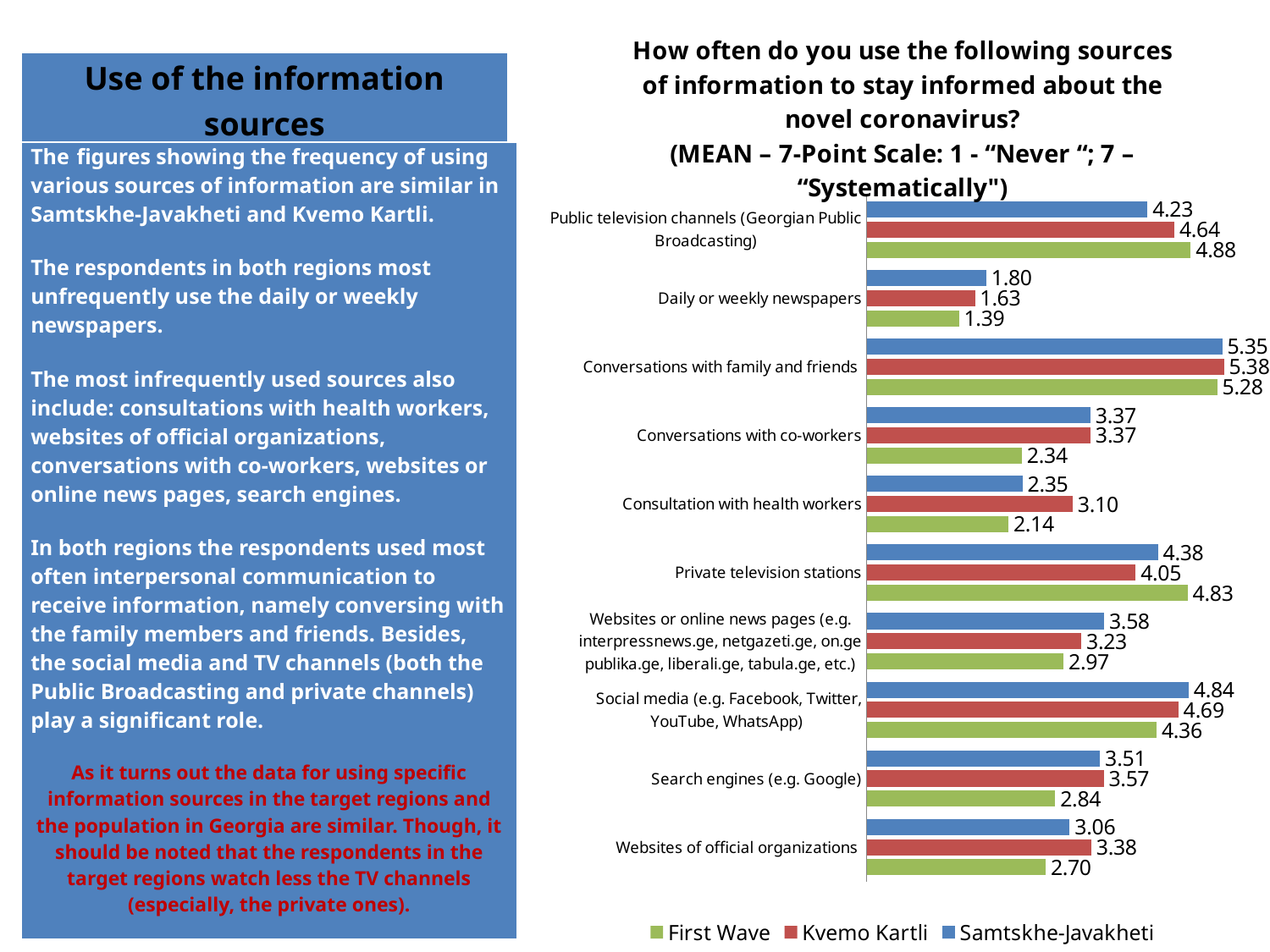
What is the Samtskhe-Javakheti value for Social media (e.g. Facebook, Twitter, YouTube, WhatsApp)? 4.84 What is the difference between the First Wave and Samtskhe-Javakheti values for Public television channels (Georgian Public Broadcasting)? 0.65 Which series is shown in green in the legend? First Wave Which source has the lowest First Wave value? Daily or weekly newspapers What is the difference between the Kvemo Kartli and First Wave values for Search engines (e.g. Google)? 0.73 What kind of chart is shown on the slide? Bar chart Which is larger for Consultation with health workers: the Kvemo Kartli value or the Samtskhe-Javakheti value? Kvemo Kartli Which source has the highest Samtskhe-Javakheti value? Conversations with family and friends What is the First Wave value for Private television stations? 4.83 How many information sources are listed on the chart? 10 How many series does the legend list? 3 What is the Kvemo Kartli value for Daily or weekly newspapers? 1.63